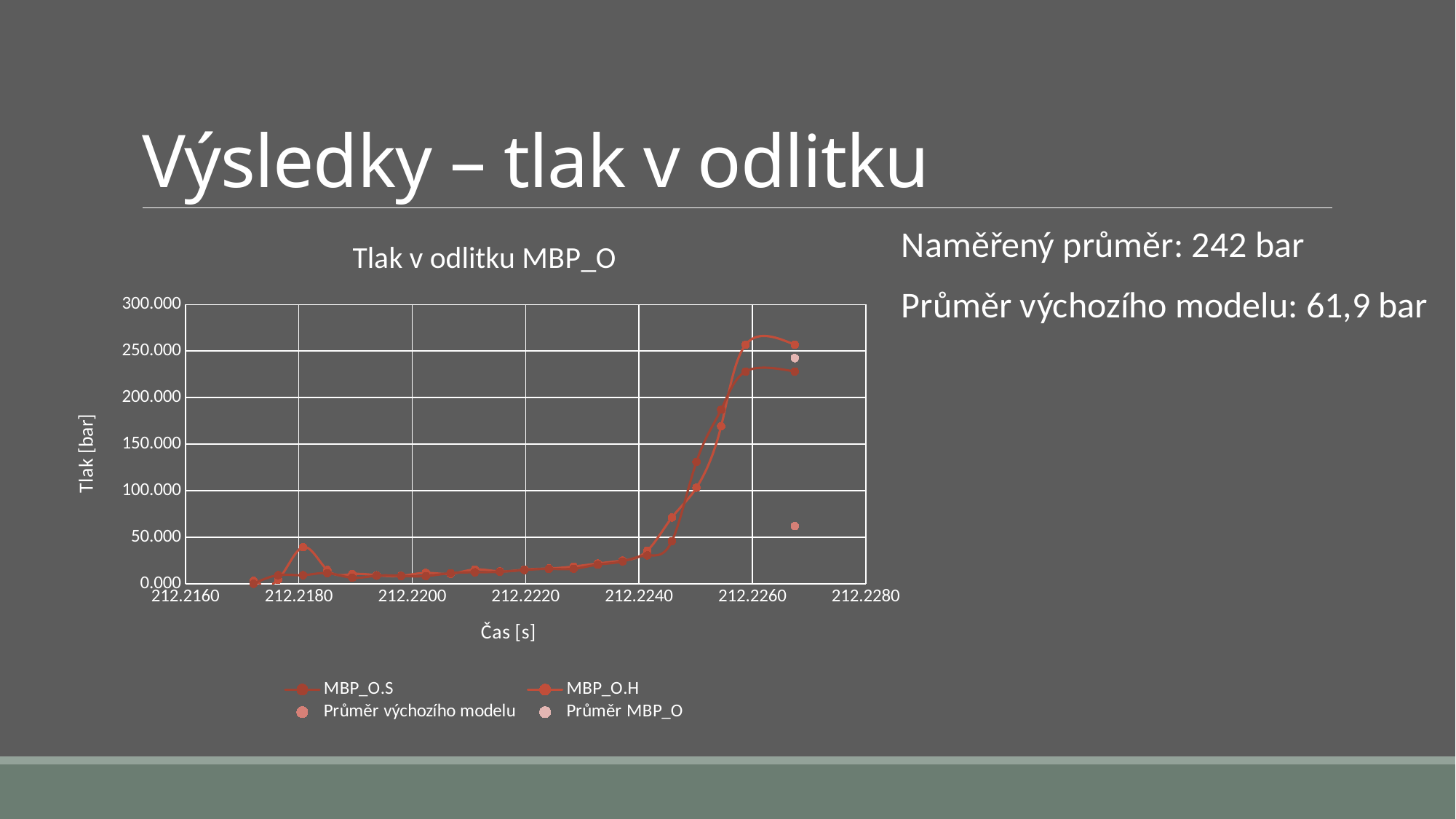
What is the label of the y axis of the chart? Tlak [bar] Is the value of the Průměr MBP_O point greater or less than 200? greater Do the plotted pressure values of the MBP_O lines overall rise or fall as time increases along the x axis? rise What kind of chart is shown on the slide? line chart Is the value of the Průměr výchozího modelu point greater or less than 100? less Which point is higher on the chart, Průměr MBP_O or Průměr výchozího modelu? Průměr MBP_O How many series does the chart legend list? 4 Is the small early peak of the line near 212.2180 s greater or less than 50? less What is the title of the chart? Tlak v odlitku MBP_O